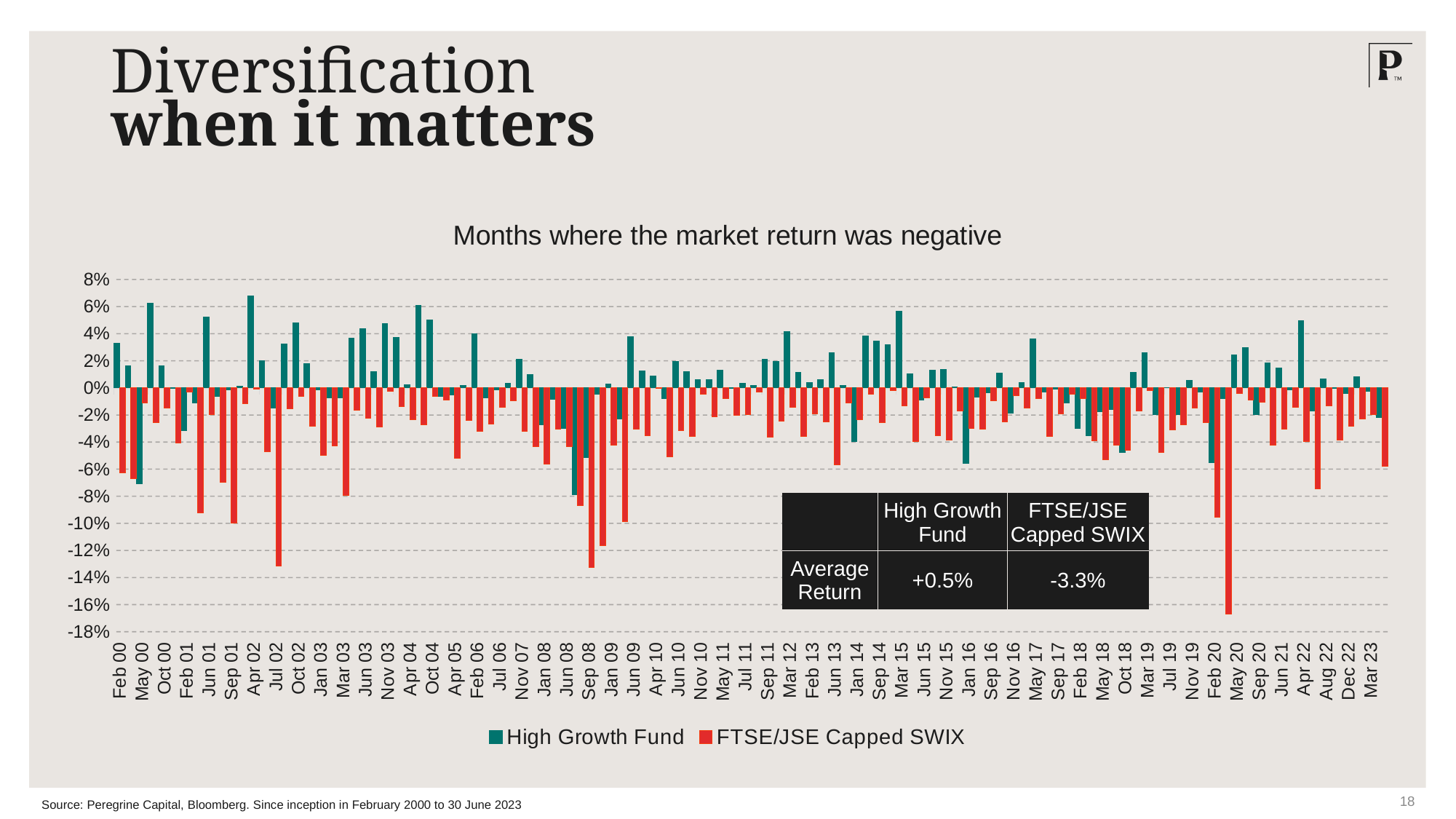
According to the table on the chart, what is the average return of the FTSE/JSE Capped SWIX? -3.3% According to the table on the chart, what is the average return of the High Growth Fund? +0.5% Which has the higher average return in the table, the High Growth Fund or the FTSE/JSE Capped SWIX? High Growth Fund What type of chart is shown on the slide? bar chart What is the title of the chart? Months where the market return was negative Is the High Growth Fund value for Feb 00 greater or less than 2%? greater What colour are the FTSE/JSE Capped SWIX bars? red For Feb 00, which series has the larger value, High Growth Fund or FTSE/JSE Capped SWIX? High Growth Fund What is the lowest value shown on the vertical axis? -18% What is the difference between the average return of the High Growth Fund (+0.5%) and the FTSE/JSE Capped SWIX (-3.3%) shown in the table? 3.8% Is the FTSE/JSE Capped SWIX value for Feb 00 greater or less than -4%? less How many series does the legend list? 2